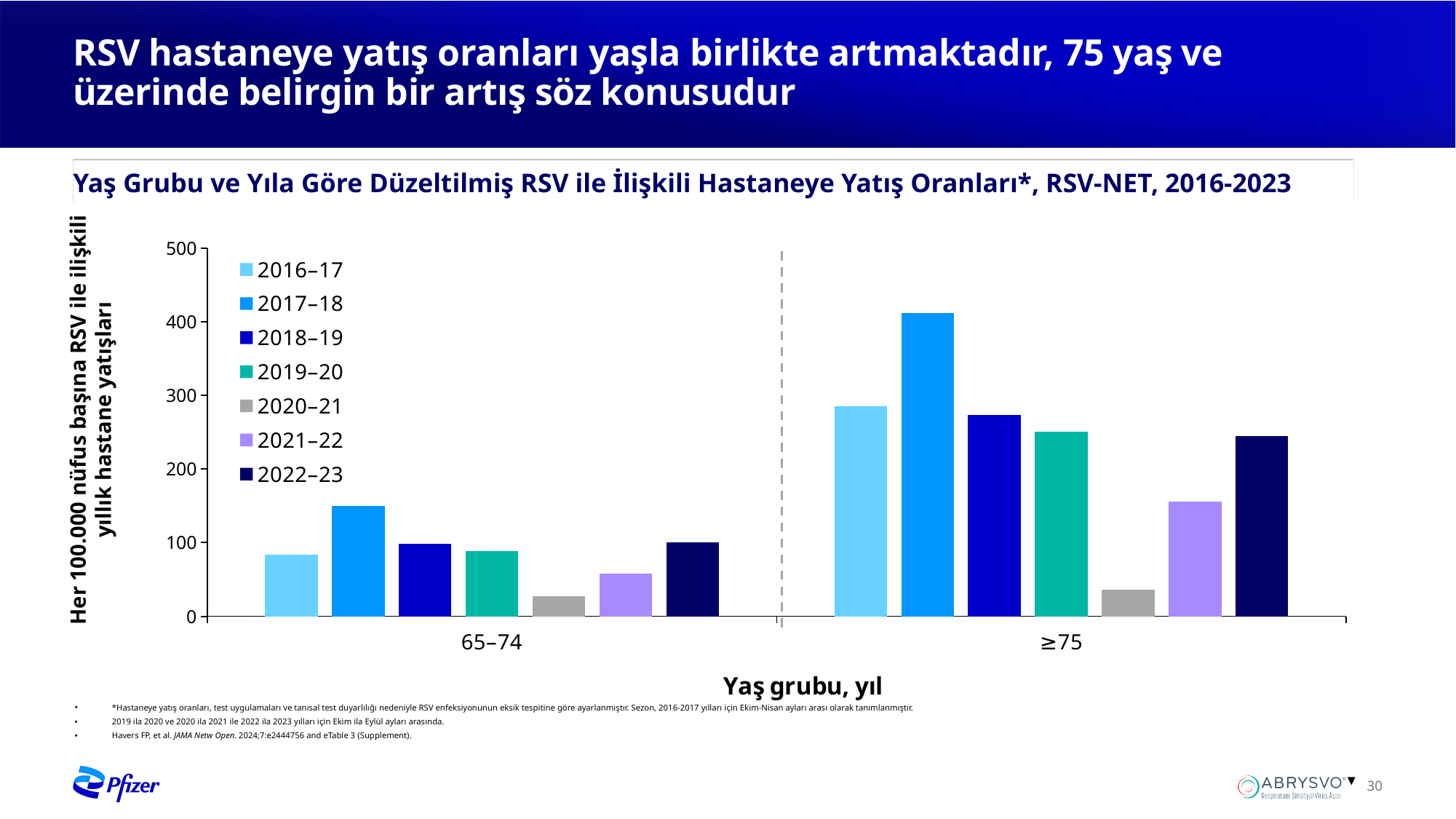
In the ≥75 age group, which season has the highest hospitalization rate? 2017–18 What kind of chart is shown on the slide? bar chart What is the label of the x axis? Yaş grubu, yıl In the ≥75 age group, which is larger: the value for 2016–17 or the value for 2021–22? 2016–17 How many age-group categories are shown on the x axis? 2 Is the value for 2021–22 in the ≥75 age group greater or less than 200? less In the 65–74 age group, which season has the lowest hospitalization rate? 2020–21 Is the value for 2020–21 in the 65–74 age group greater or less than 100? less Is the value for 2017–18 in the ≥75 age group greater or less than 300? greater How many series does the legend list? 7 In the ≥75 age group, which season has the lowest hospitalization rate? 2020–21 In the 65–74 age group, which season has the highest hospitalization rate? 2017–18